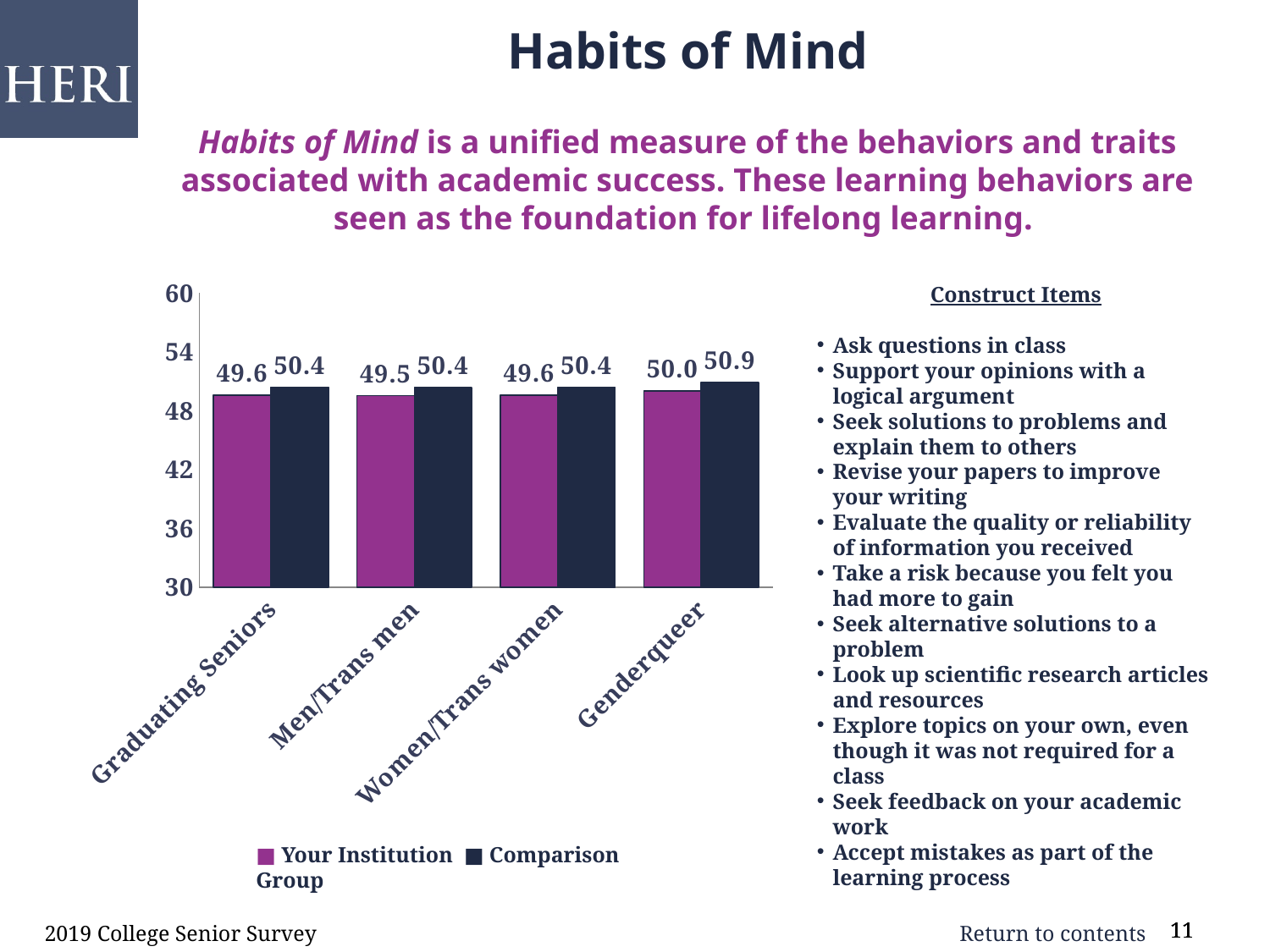
Is the Your Institution value for Genderqueer greater or less than 48? greater What is the Comparison Group value for Women/Trans women? 50.4 For Graduating Seniors, which is larger: Your Institution or Comparison Group? Comparison Group Which category has the lowest Your Institution value? Men/Trans men Which category has the highest Comparison Group value? Genderqueer What is the difference between the Comparison Group and Your Institution values for Genderqueer? 0.9 How many categories are shown on the x axis? 4 How many series does the legend list? 2 What is the Your Institution value for Graduating Seniors? 49.6 What is the Your Institution value for Men/Trans men? 49.5 What kind of chart is shown on the slide? bar chart What is the Comparison Group value for Genderqueer? 50.9